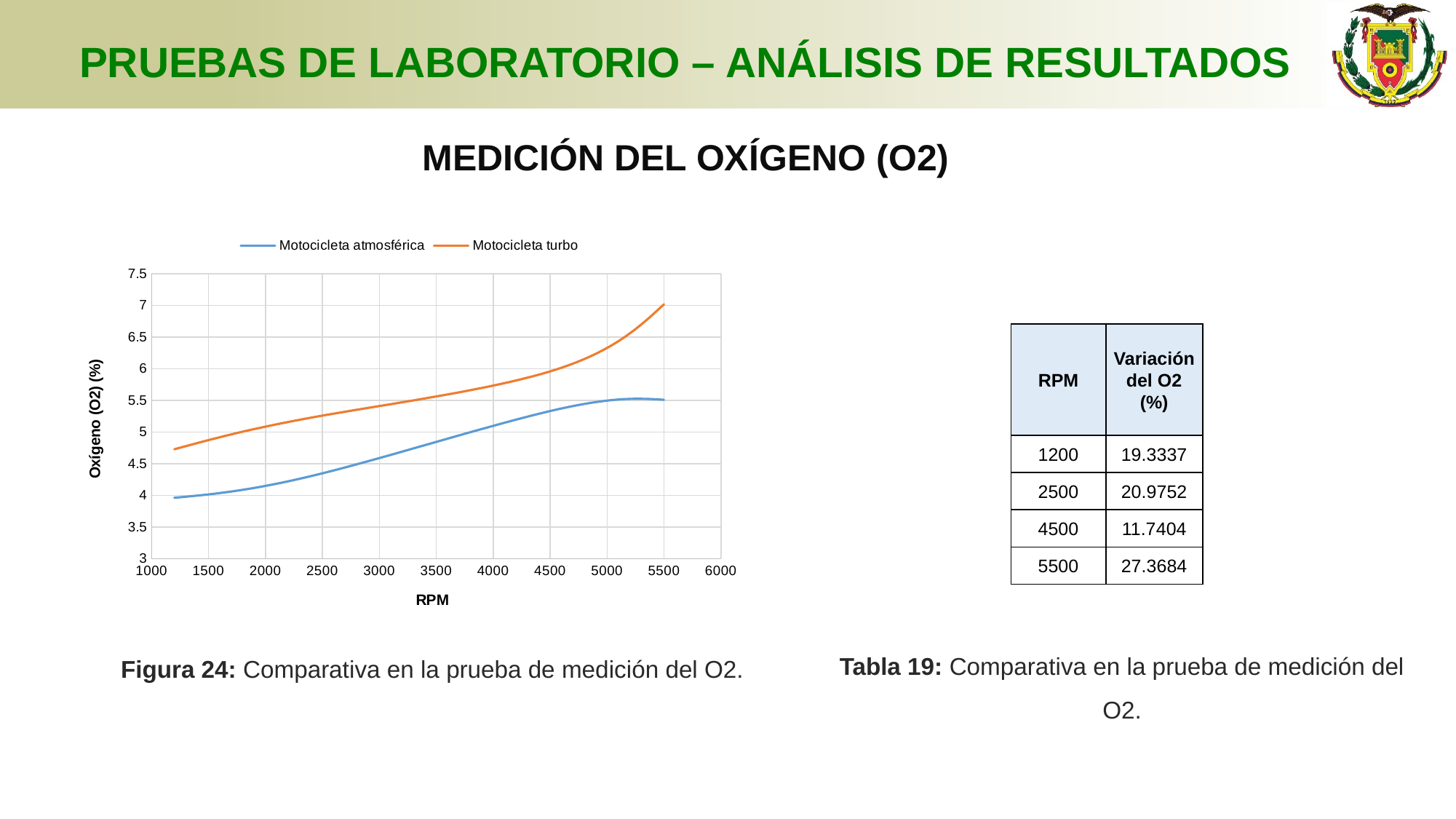
Is the value for Motocicleta atmosférica at 1200 RPM greater or less than 4.5? less Is the value for Motocicleta turbo at 1200 RPM greater or less than 4.5? greater At 3000 RPM, which series has the higher oxygen value, Motocicleta atmosférica or Motocicleta turbo? Motocicleta turbo What is the title of the vertical axis of the chart? Oxígeno (O2) (%) Is the value for Motocicleta turbo at 3000 RPM greater or less than 5? greater Does the Motocicleta turbo line rise or fall as RPM increases? rises Which series is plotted in orange on the chart? Motocicleta turbo What kind of chart is shown in Figura 24? line chart How many series does the legend of the chart list? 2